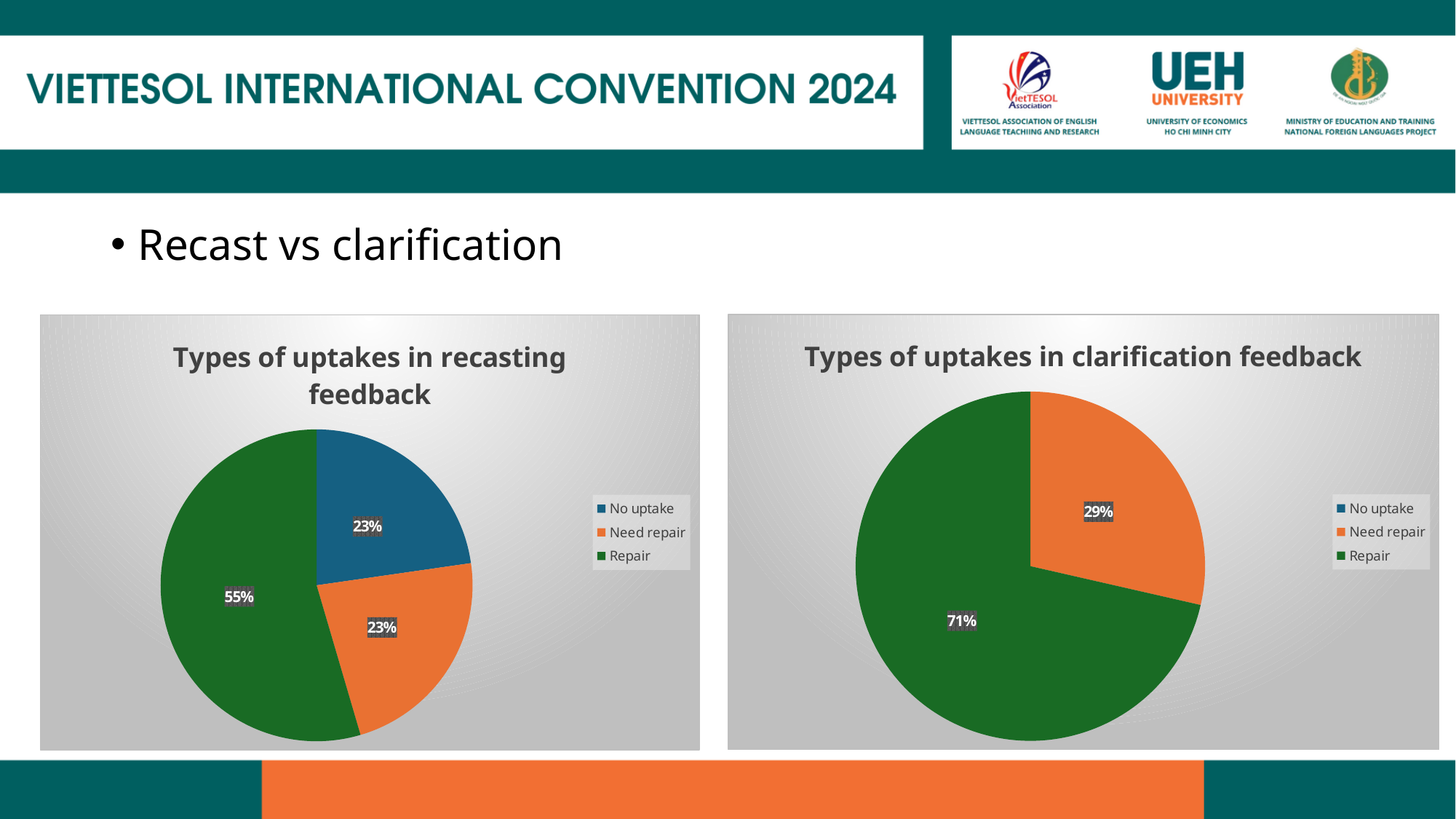
In the 'Types of uptakes in clarification feedback' chart, what share does Repair have? 71% In the 'Types of uptakes in recasting feedback' chart, what share does No uptake have? 23% In the 'Types of uptakes in recasting feedback' chart, what is the difference between the Repair share and the Need repair share? 32 percentage points In the 'Types of uptakes in recasting feedback' chart, what colour represents Need repair? Orange In the 'Types of uptakes in recasting feedback' chart, what share does Repair have? 55% How many entries does the legend of the 'Types of uptakes in recasting feedback' chart list? 3 In the 'Types of uptakes in clarification feedback' chart, which labelled category has the largest share? Repair What type of chart is used on the left side of the slide? Pie chart In the 'Types of uptakes in clarification feedback' chart, what share does Need repair have? 29% In the 'Types of uptakes in recasting feedback' chart, which category has the largest share? Repair Is the Repair share larger in the recasting feedback chart or in the clarification feedback chart? Clarification feedback chart In the 'Types of uptakes in clarification feedback' chart, what is the difference between the Repair share and the Need repair share? 42 percentage points